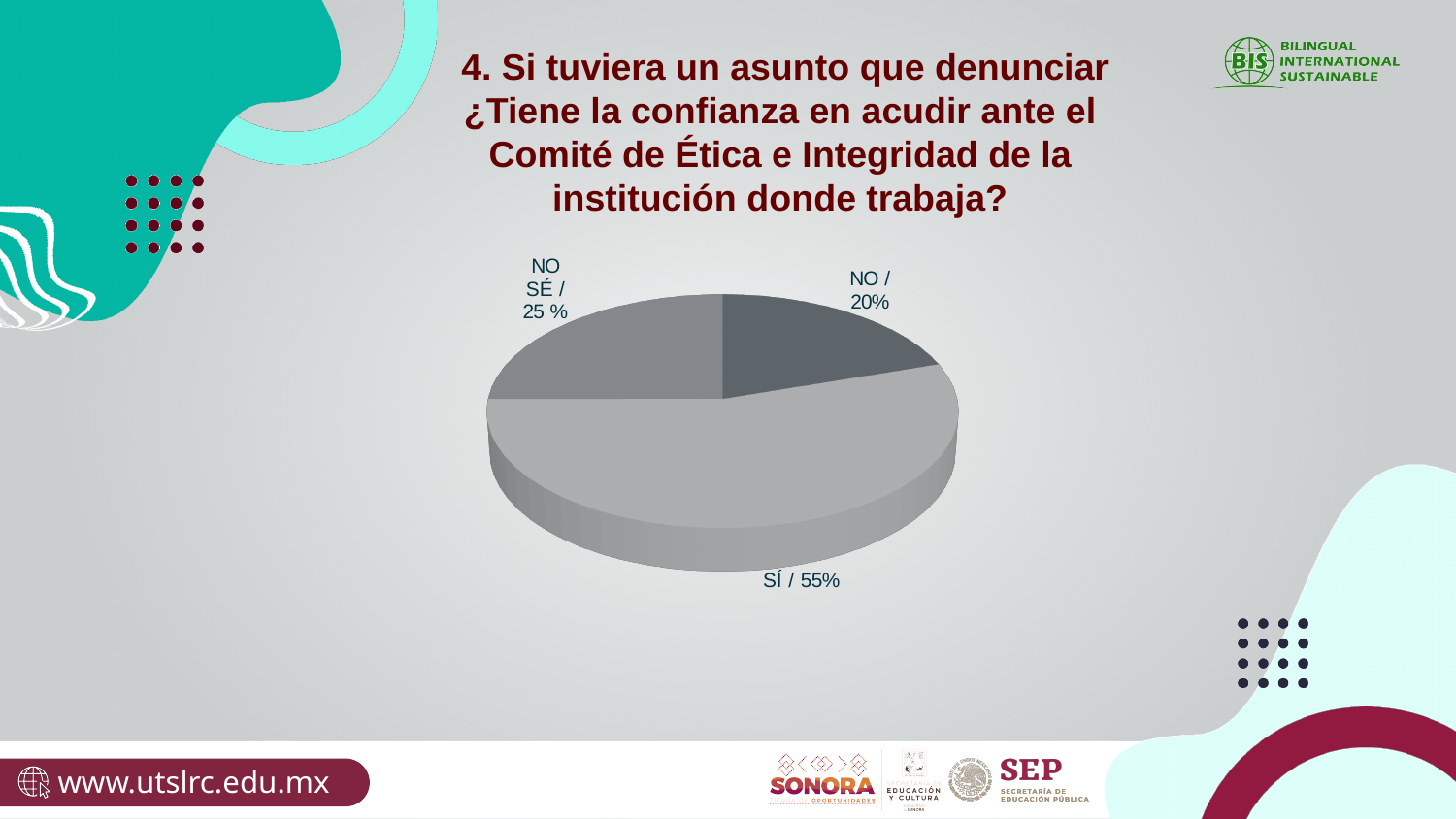
Which slice of the pie chart is the largest? SÍ What percentage of the pie is labelled NO? 20% What is the difference in percentage points between the NO SÉ slice and the NO slice? 5 How many slices does the pie chart have? 3 What share of the pie do the NO and NO SÉ slices make up together? 45% What is the number of the survey question shown in the chart title? 4 Which is larger, the NO SÉ slice or the NO slice? NO SÉ What kind of chart is shown on the slide? pie chart What is the difference in percentage points between the SÍ slice and the NO slice? 35 What percentage of the pie is labelled SÍ? 55% What percentage of the pie is labelled NO SÉ? 25 % Which slice of the pie chart is the smallest? NO